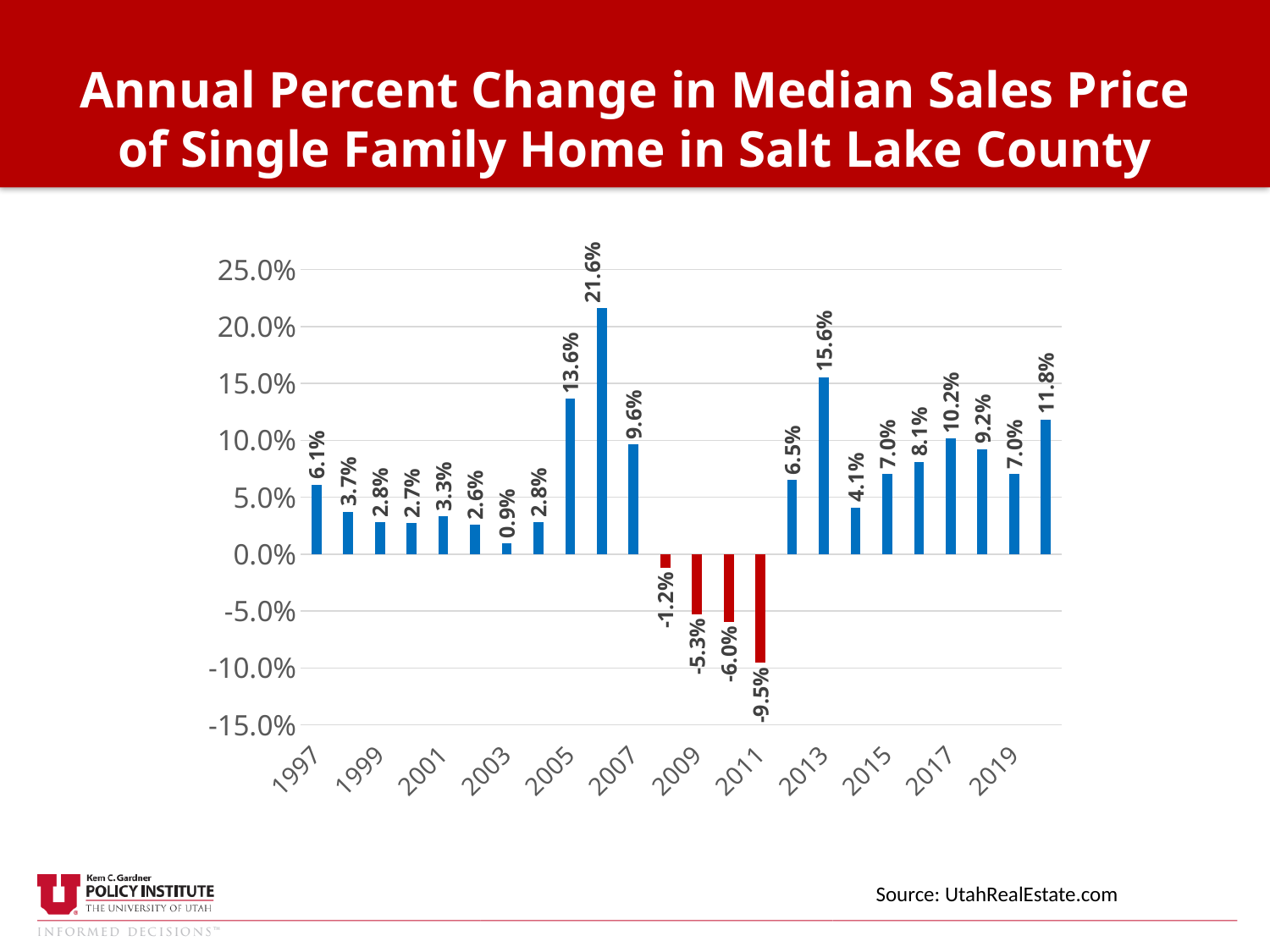
What type of chart is shown on the slide? Bar chart Is the value for 2019 greater or less than 10.0%? less What is the annual percent change shown for 2011? -9.5% Which year has a larger annual percent change, 2007 or 2017? 2017 What is the annual percent change shown for 1997? 6.1% How many bars show a negative annual percent change? 4 What colour are the bars with negative values? Red What is the annual percent change shown for 2005? 13.6% What is the highest annual percent change value labeled on the chart? 21.6% Which year has the lowest annual percent change? 2011 What is the annual percent change shown for 2013? 15.6% What is the difference between the values for 2013 and 2015? 8.6%